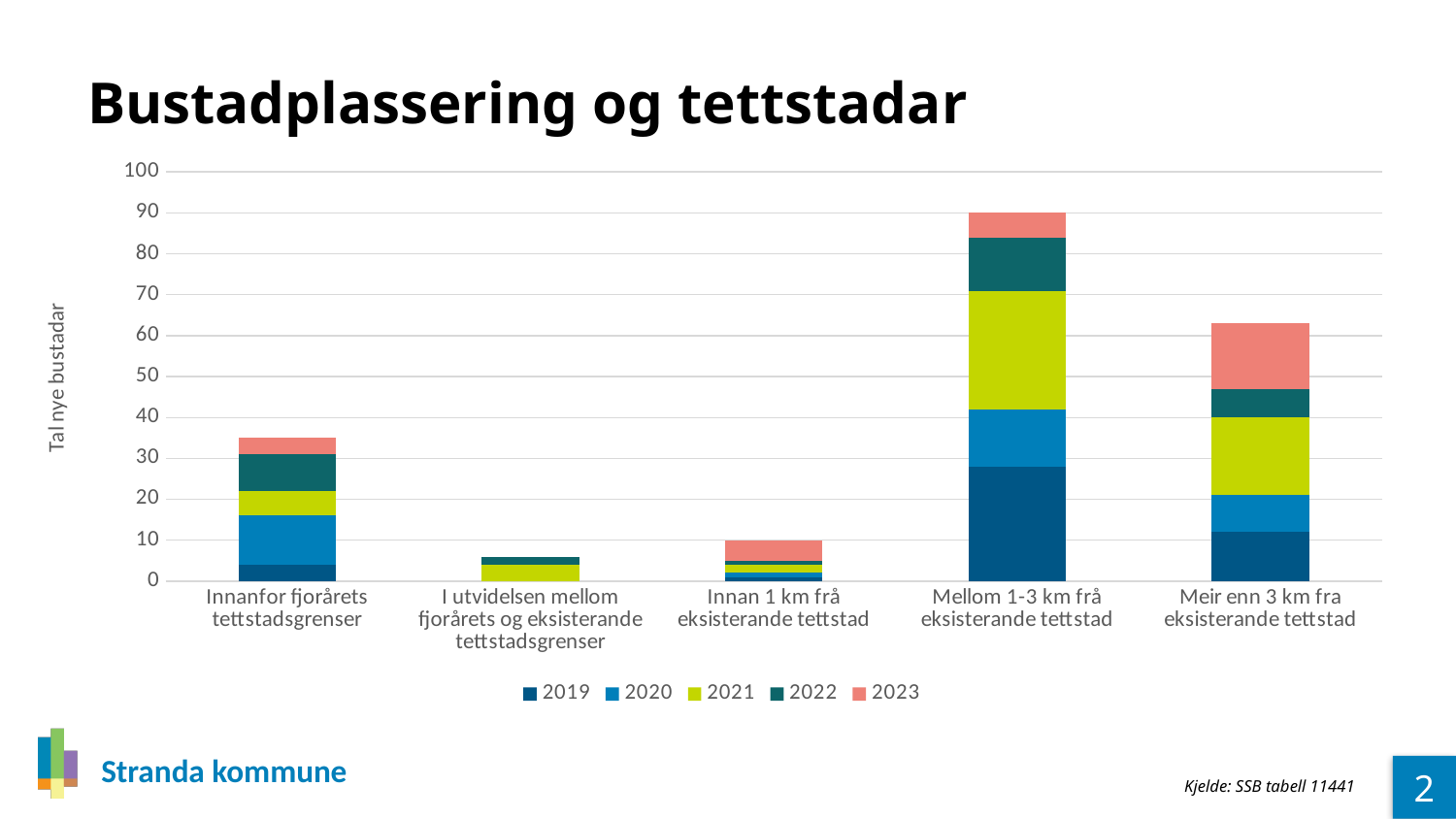
Which has a taller stacked bar: 'Meir enn 3 km fra eksisterande tettstad' or 'Mellom 1-3 km frå eksisterande tettstad'? Mellom 1-3 km frå eksisterande tettstad What is the title of the slide? Bustadplassering og tettstadar Is the total stacked bar for 'Innanfor fjorårets tettstadsgrenser' greater or less than 40? less How many series does the legend list? 5 How many categories are shown along the x axis? 5 Is the total stacked bar for 'Mellom 1-3 km frå eksisterande tettstad' greater or less than 80? greater Which category has the shortest stacked bar? I utvidelsen mellom fjorårets og eksisterande tettstadsgrenser What is the label on the y axis? Tal nye bustadar Which category has the tallest stacked bar? Mellom 1-3 km frå eksisterande tettstad Is the total stacked bar for 'Meir enn 3 km fra eksisterande tettstad' greater or less than 50? greater What kind of chart is shown on the slide? stacked bar chart Which has a taller stacked bar: 'Innanfor fjorårets tettstadsgrenser' or 'Innan 1 km frå eksisterande tettstad'? Innanfor fjorårets tettstadsgrenser